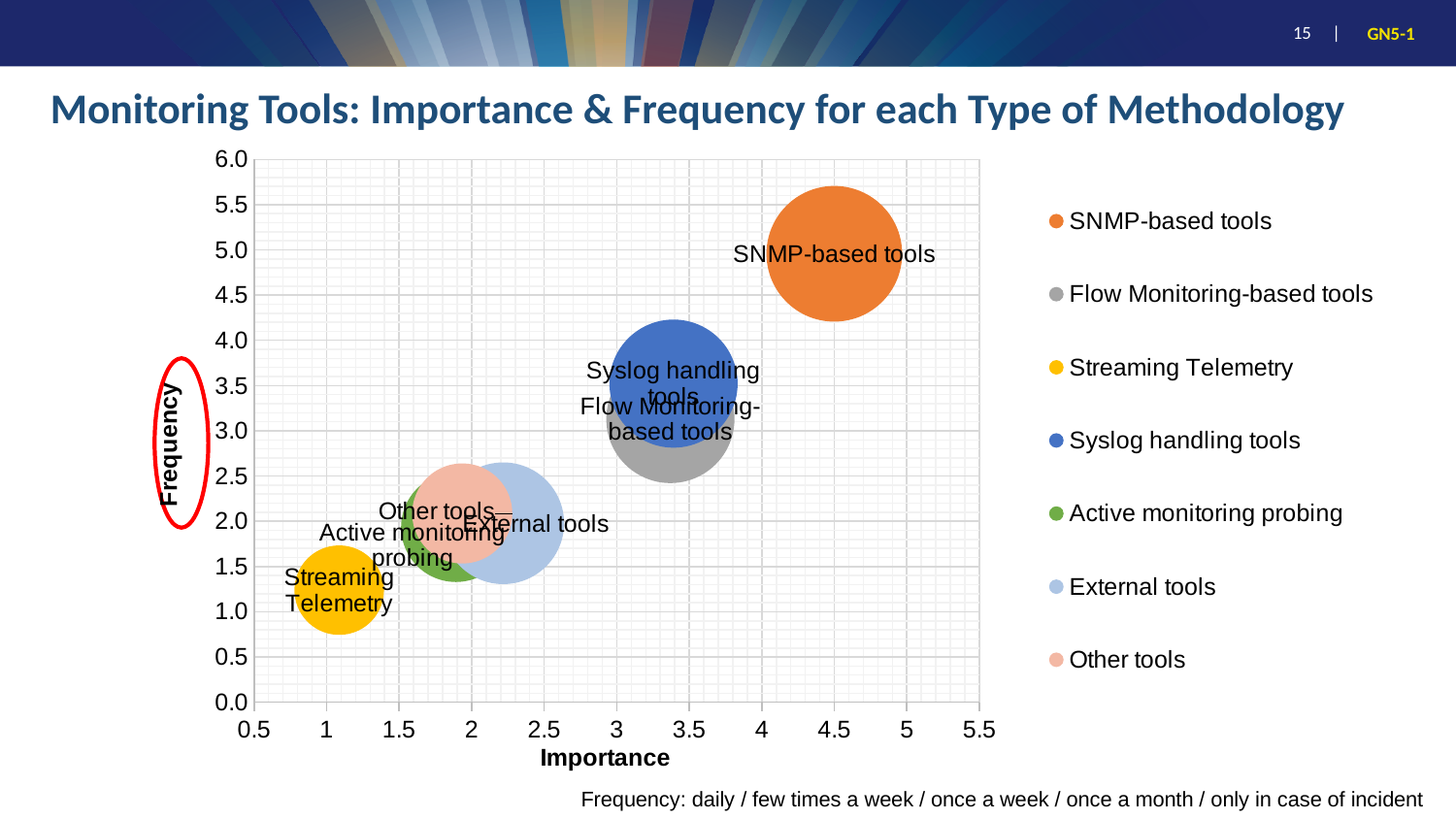
Which monitoring tool type has the lowest Importance? Streaming Telemetry Is the Importance value for Flow Monitoring-based tools greater or less than 3? greater How many series does the legend list? 7 How many bubbles are plotted on the chart? 7 What is the label of the horizontal axis? Importance Which has the higher Importance, SNMP-based tools or External tools? SNMP-based tools Is the Frequency value for SNMP-based tools greater or less than 4.5? greater Which monitoring tool type has the highest Frequency? SNMP-based tools What colour is the bubble for SNMP-based tools? orange Is the Importance value for Streaming Telemetry greater or less than 1.5? less What kind of chart is shown on the slide? bubble chart